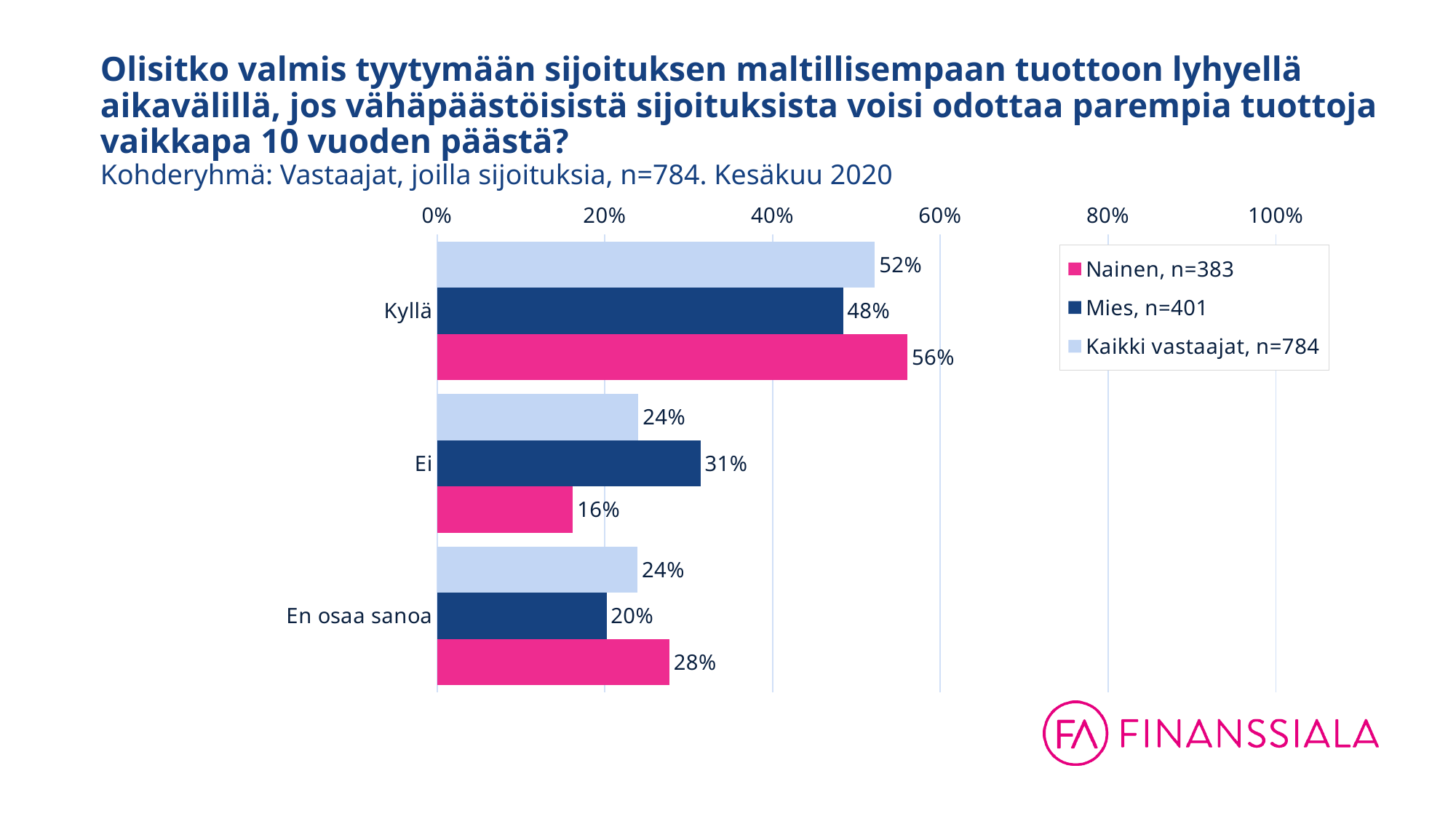
How many categories are shown on the y axis? 3 Which category has the lowest value for Nainen, n=383? Ei What is the difference between the Nainen, n=383 and Mies, n=401 values in the Kyllä category? 8% How many series does the legend list? 3 Which category has the highest value for Mies, n=401? Kyllä What is the value for Nainen, n=383 in the Kyllä category? 56% What kind of chart is shown on the slide? bar chart In the Ei category, which is larger: the value for Mies, n=401 or the value for Nainen, n=383? Mies, n=401 What is the value for Mies, n=401 in the Ei category? 31% Is the value for Kaikki vastaajat, n=784 in the Kyllä category greater or less than 40%? greater Which legend entry is shown in pink? Nainen, n=383 What is the value for Kaikki vastaajat, n=784 in the En osaa sanoa category? 24%